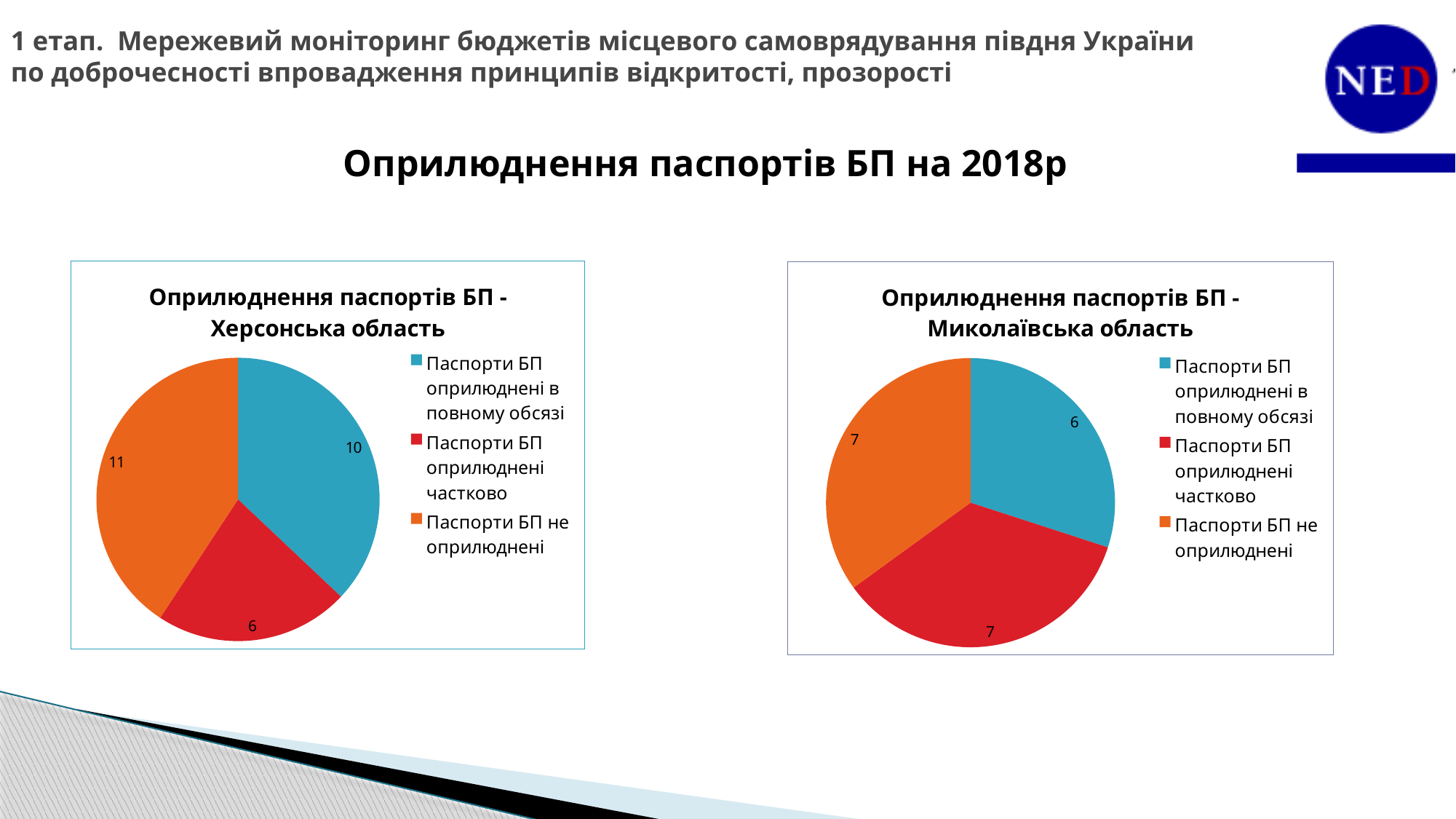
In the chart 'Оприлюднення паспортів БП - Херсонська область', what is the value for 'Паспорти БП оприлюднені в повному обсязі'? 10 In the chart 'Оприлюднення паспортів БП - Херсонська область', which category has the smallest slice? Паспорти БП оприлюднені частково In the chart 'Оприлюднення паспортів БП - Миколаївська область', what is the value for 'Паспорти БП оприлюднені частково'? 7 How many slices does the chart 'Оприлюднення паспортів БП - Миколаївська область' have? 3 In the chart 'Оприлюднення паспортів БП - Миколаївська область', which category has the smallest slice? Паспорти БП оприлюднені в повному обсязі In the chart 'Оприлюднення паспортів БП - Миколаївська область', which is larger: 'Паспорти БП не оприлюднені' or 'Паспорти БП оприлюднені в повному обсязі'? Паспорти БП не оприлюднені What type of chart is used for 'Оприлюднення паспортів БП - Херсонська область'? pie chart In the chart 'Оприлюднення паспортів БП - Миколаївська область', what is the value for 'Паспорти БП оприлюднені в повному обсязі'? 6 In the chart 'Оприлюднення паспортів БП - Херсонська область', what colour is the slice for 'Паспорти БП оприлюднені частково'? red In the chart 'Оприлюднення паспортів БП - Херсонська область', what is the value for 'Паспорти БП не оприлюднені'? 11 In the chart 'Оприлюднення паспортів БП - Херсонська область', which category has the largest slice? Паспорти БП не оприлюднені In the chart 'Оприлюднення паспортів БП - Херсонська область', what is the difference between 'Паспорти БП не оприлюднені' and 'Паспорти БП оприлюднені частково'? 5